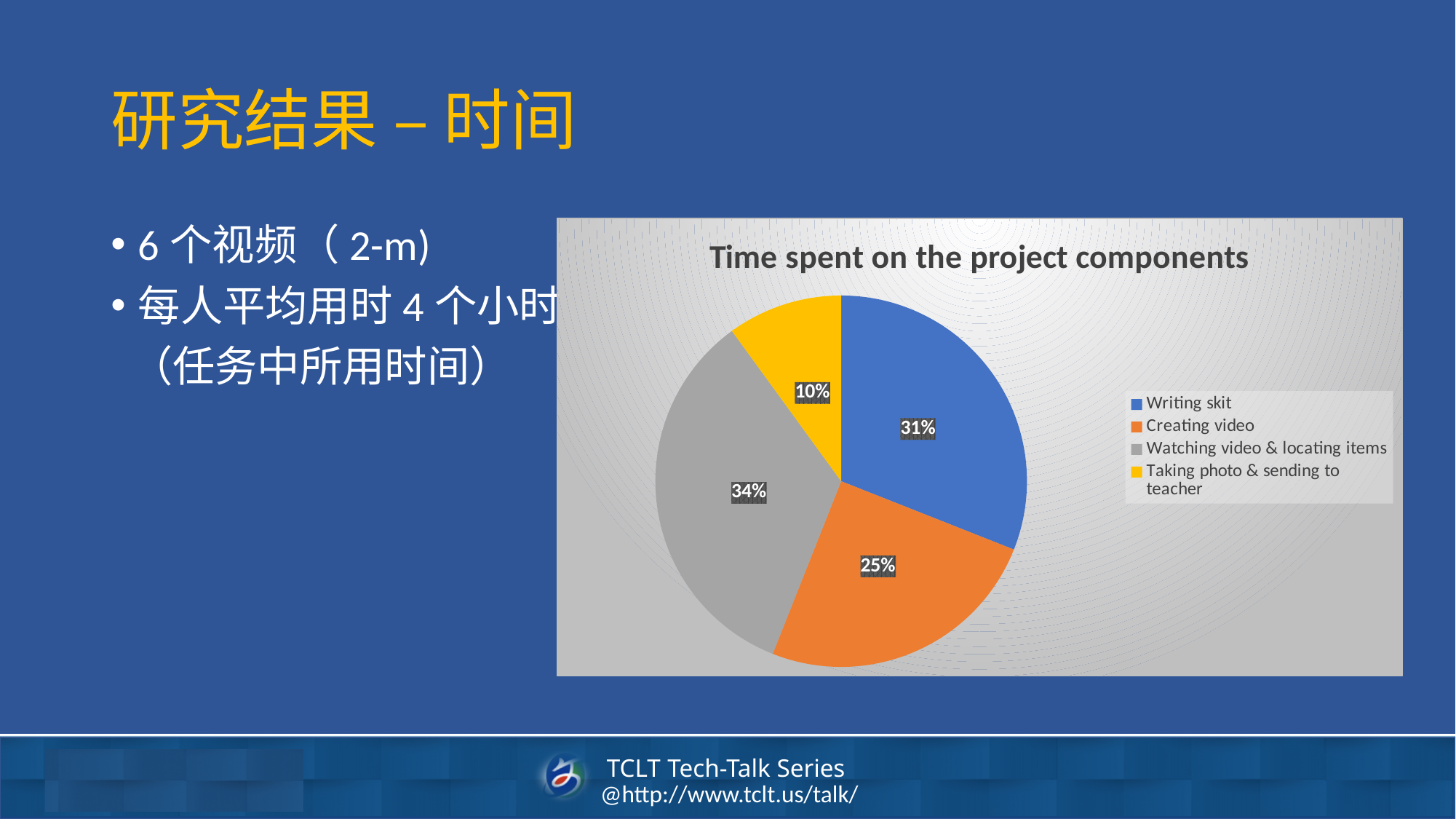
Which took a larger share of time, Writing skit or Creating video? Writing skit What share of time was spent on Watching video & locating items? 34% What share of time was spent on Writing skit? 31% What share of time was spent on Taking photo & sending to teacher? 10% Which project component took the largest share of time? Watching video & locating items Which colour represents Creating video in the pie chart? orange What is the difference in percentage points between Writing skit and Creating video? 6 What share of time was spent on Creating video? 25% Which project component took the smallest share of time? Taking photo & sending to teacher What is the title of the chart? Time spent on the project components What type of chart is shown on the slide? pie chart How many slices does the pie chart have? 4